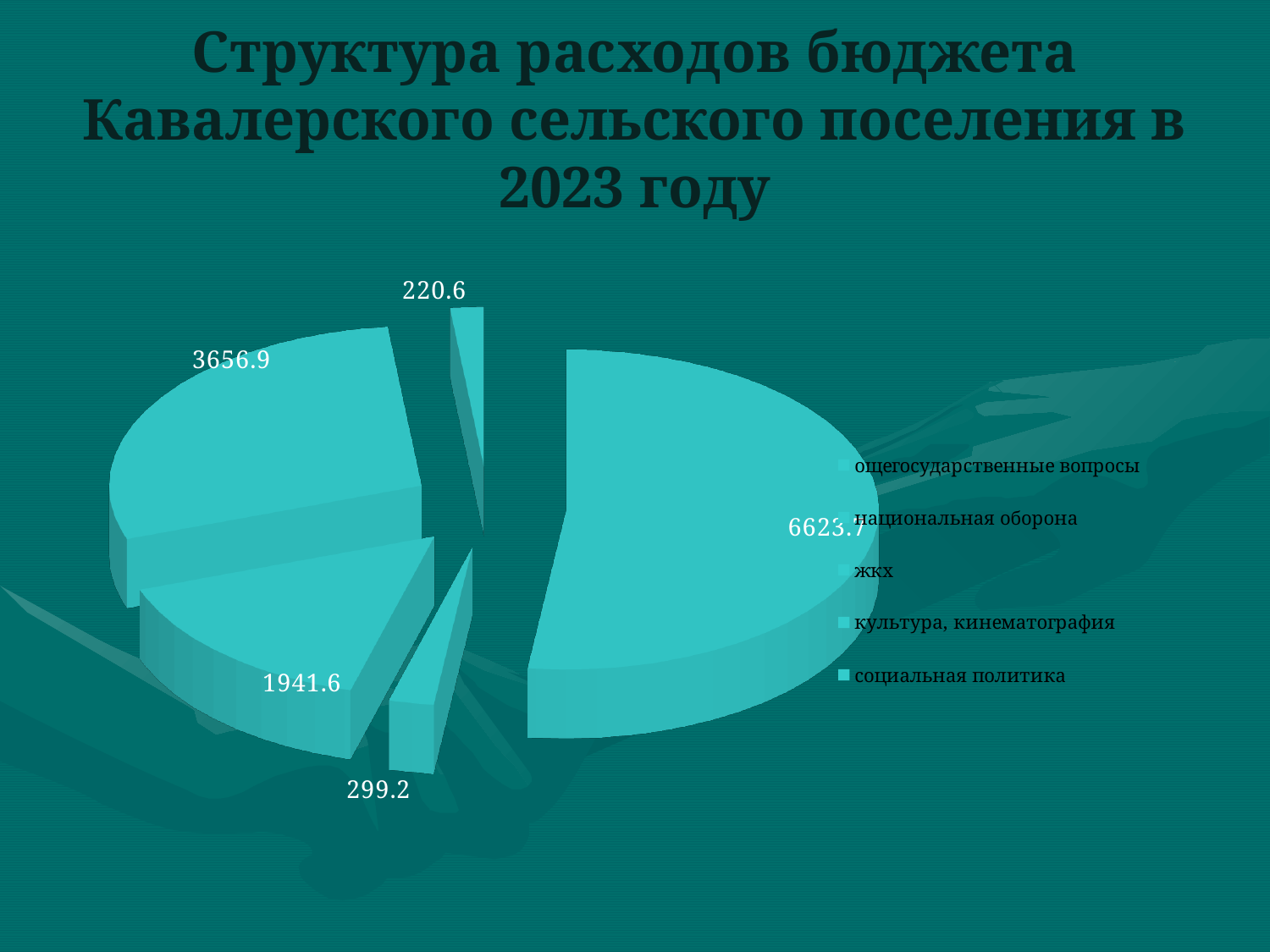
How many slices does the pie chart have? 5 How many entries does the legend of the pie chart list? 5 What kind of chart is shown on the slide? pie chart What is the difference between the slices labelled 3656.9 and 1941.6? 1715.3 What is the smallest value labelled on the pie chart? 220.6 Which legend entry is listed last in the pie chart's legend? социальная политика What is the total of all the values labelled on the pie chart? 12742.0 Which is larger: the slice labelled 1941.6 or the slice labelled 299.2? 1941.6 What is the difference between the two smallest labelled values, 299.2 and 220.6? 78.6 What is the largest value labelled on the pie chart? 6623.7 What is the difference between the largest labelled value (6623.7) and the second largest (3656.9)? 2966.8 What is the title of the chart slide? Структура расходов бюджета Кавалерского сельского поселения в 2023 году